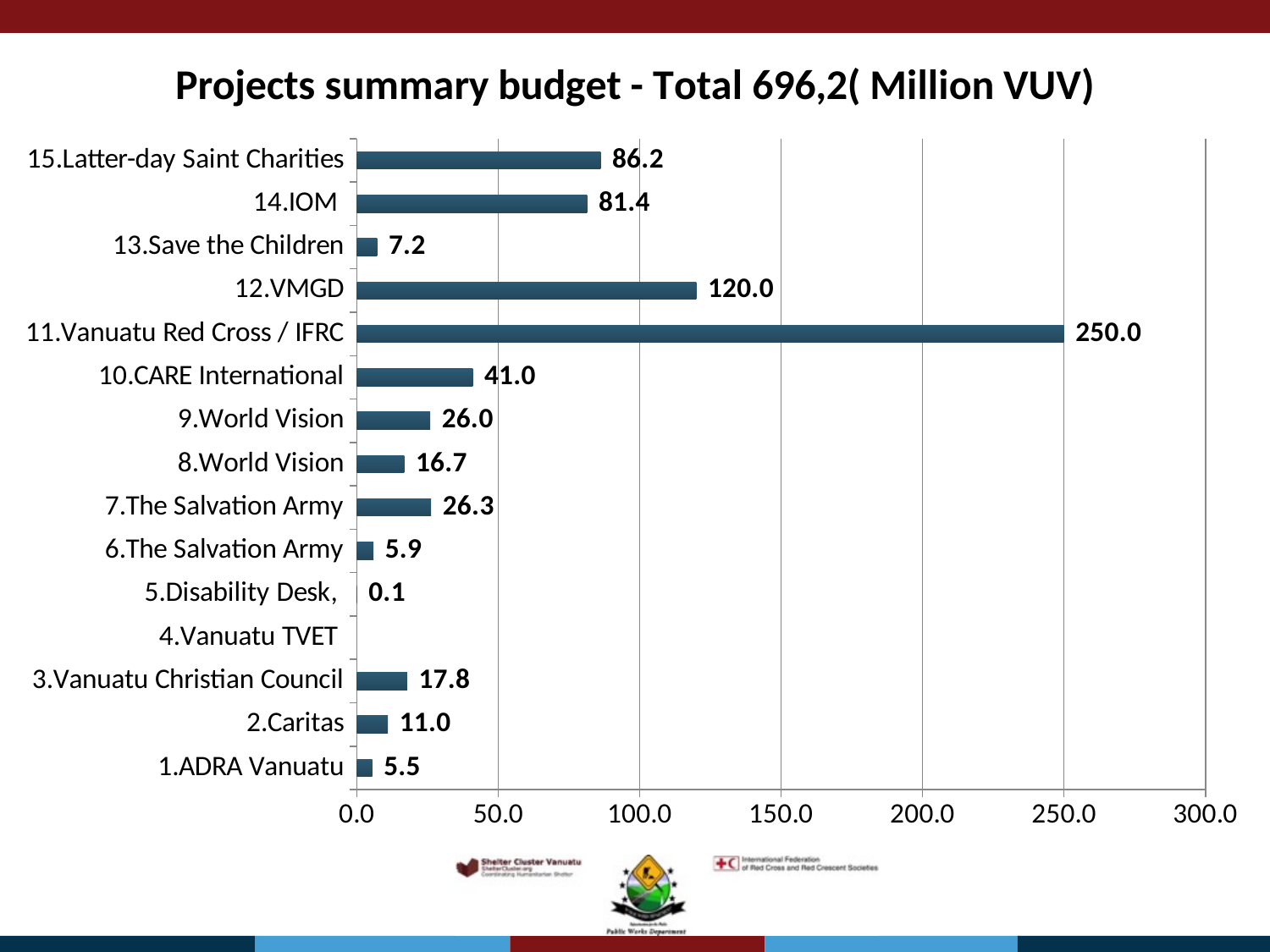
Which organisation has the highest budget in the chart? 11.Vanuatu Red Cross / IFRC Is the value for 14.IOM greater or less than 100.0? less What is the difference between the values for 11.Vanuatu Red Cross / IFRC and 12.VMGD? 130.0 What is the budget value shown for 11.Vanuatu Red Cross / IFRC? 250.0 Which has a larger value, 12.VMGD or 14.IOM? 12.VMGD What value is shown for 5.Disability Desk? 0.1 What is the title of the chart? Projects summary budget - Total 696,2( Million VUV) What value is shown for 3.Vanuatu Christian Council? 17.8 What is the difference between the values for 15.Latter-day Saint Charities and 14.IOM? 4.8 How many categories are listed on the vertical axis of the chart? 15 What value is shown for 12.VMGD? 120.0 What kind of chart is shown on the slide? Bar chart